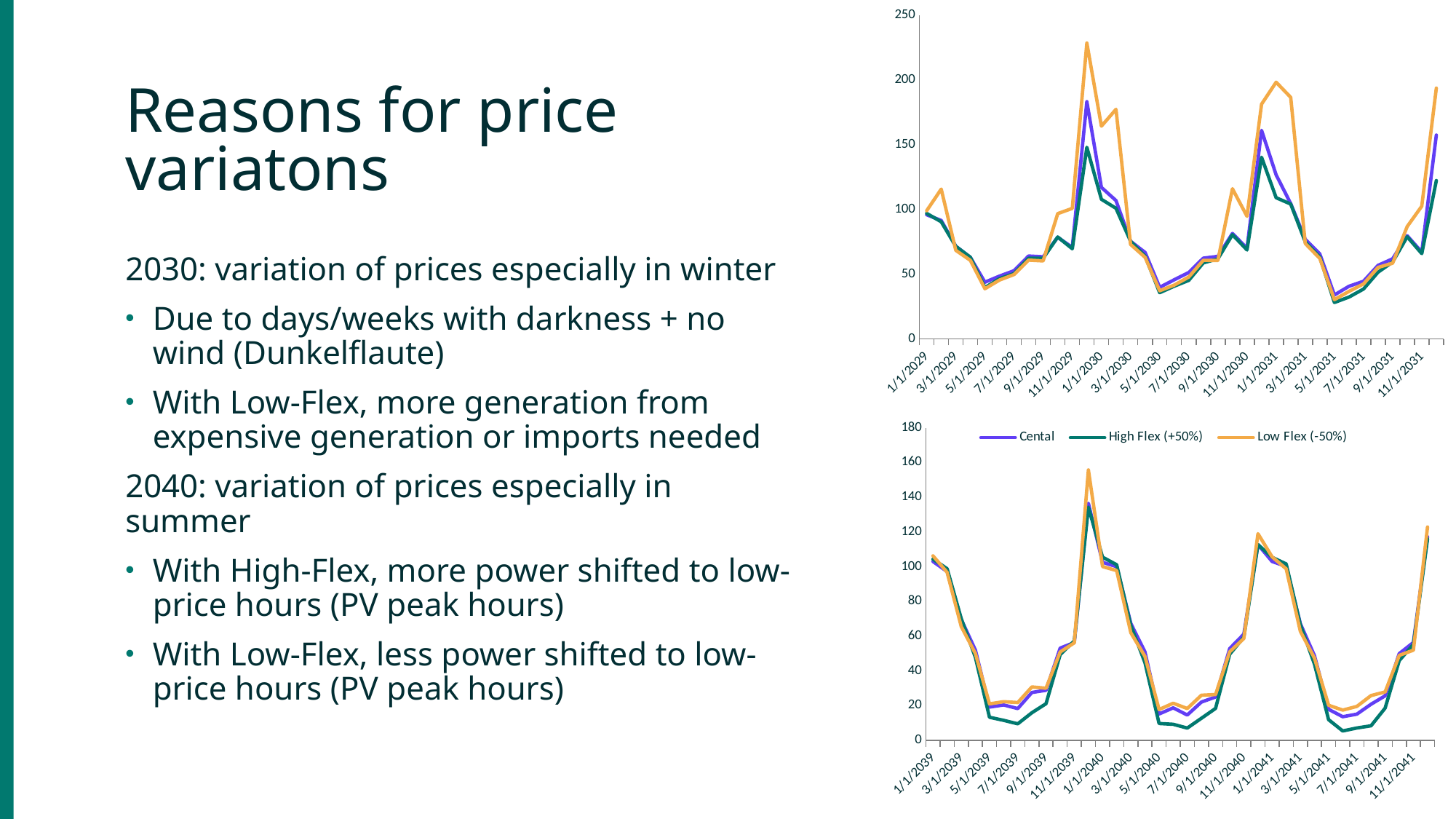
How many series does the legend on the bottom chart list? 3 In the bottom chart, which series is higher at 7/1/2041: Low Flex (-50%) or High Flex (+50%)? Low Flex (-50%) In the top chart, which series is higher at 1/1/2031: Low Flex (-50%) or High Flex (+50%)? Low Flex (-50%) In the top chart, is the value of the High Flex (+50%) series at 5/1/2031 greater or less than 50? less What is the highest value shown on the y axis of the top chart? 250 In the bottom chart, is the peak value of the Low Flex (-50%) series around 1/1/2040 greater or less than 140? greater In the bottom chart, do the values rise or fall from 1/1/2039 to 7/1/2039? fall In the bottom chart, is the value of the High Flex (+50%) series at 7/1/2039 greater or less than 20? less What are the three series named in the legend of the bottom chart? Cental, High Flex (+50%), Low Flex (-50%) What kind of chart is the top chart on the slide? line chart